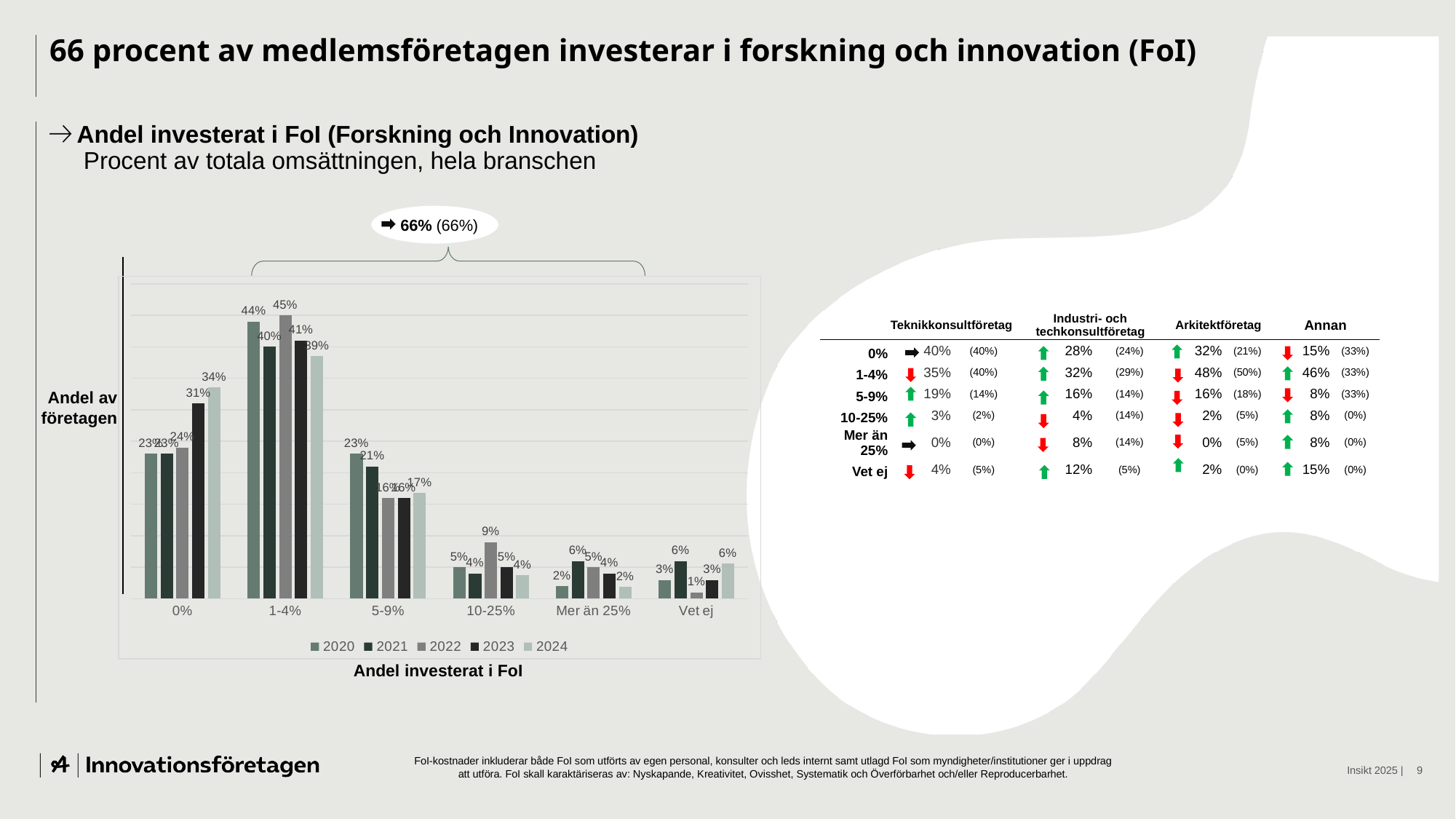
What is the value for 2024 in the 0% category? 34% For the 2024 series, do the values rise or fall from the 1-4% category to the Mer än 25% category? Fall What is the difference between the 2024 and 2020 values in the 0% category? 11 percentage points What is the value for 2022 in the 1-4% category? 45% How many categories are shown on the x axis? 6 What is the title printed below the x axis of the chart? Andel investerat i FoI What is the value for 2022 in the 10-25% category? 9% For the 2023 series, which category has the larger value: 0% or 5-9%? 0% What kind of chart is shown on the slide? Bar chart Which category has the lowest value for the 2022 series? Vet ej Which category has the highest value for the 2024 series? 1-4% How many series does the legend list? 5